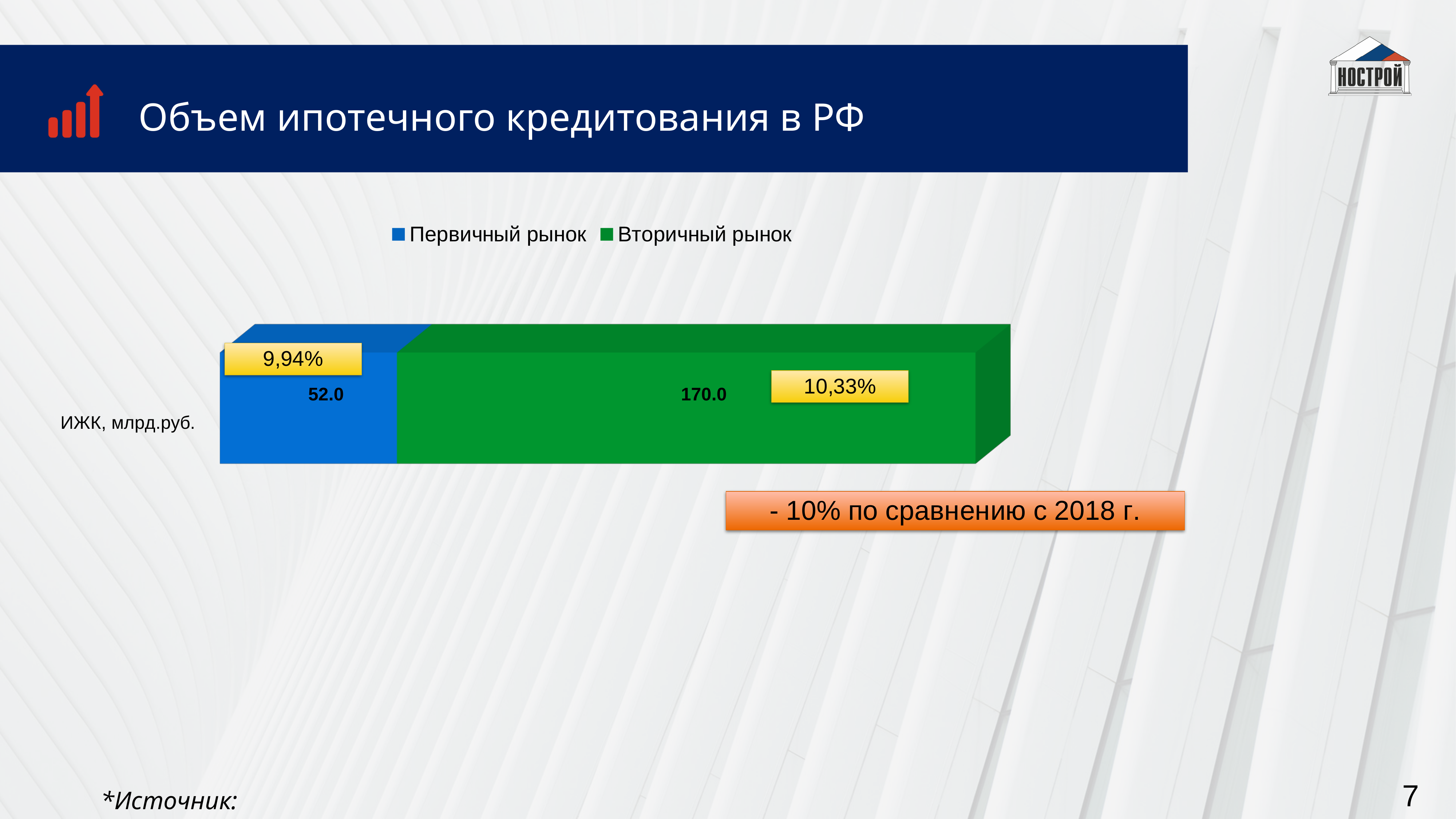
What is the difference between the Вторичный рынок value and the Первичный рынок value? 118.0 What is the title of the slide containing the chart? Объем ипотечного кредитования в РФ What kind of chart is shown on the slide? Stacked bar chart What is the total of the stacked bar for ИЖК, млрд.руб.? 222.0 What colour represents Вторичный рынок in the chart? Green How many series does the legend list? 2 What is the value for Первичный рынок in the ИЖК, млрд.руб. bar? 52.0 Which series has the largest value in the chart? Вторичный рынок Which series has the larger value, Первичный рынок or Вторичный рынок? Вторичный рынок What is the value for Вторичный рынок in the ИЖК, млрд.руб. bar? 170.0 Which series has the smallest value in the chart? Первичный рынок How many categories are plotted in the chart? 1